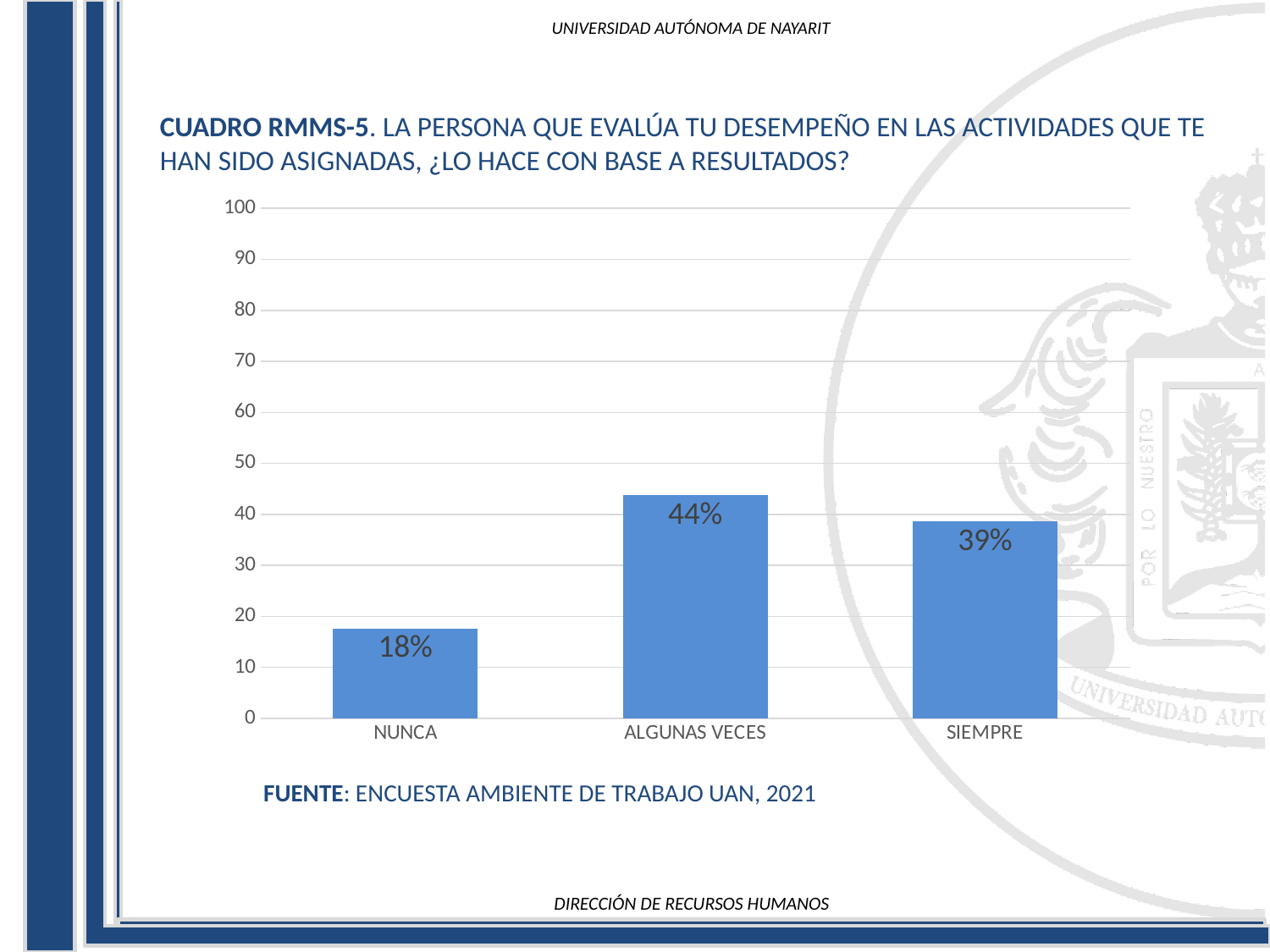
Which category has the highest value? ALGUNAS VECES What is the source cited below the chart? ENCUESTA AMBIENTE DE TRABAJO UAN, 2021 What is the difference between the values for SIEMPRE and NUNCA? 21% What is the value for ALGUNAS VECES? 44% What is the value for SIEMPRE? 39% What is the difference between the values for ALGUNAS VECES and SIEMPRE? 5% Is the value for ALGUNAS VECES greater or less than 50? less Which category has the lowest value? NUNCA Which is larger, the value for NUNCA or the value for SIEMPRE? SIEMPRE What kind of chart is shown on the slide? bar chart How many categories are shown on the x axis? 3 What is the value for NUNCA? 18%